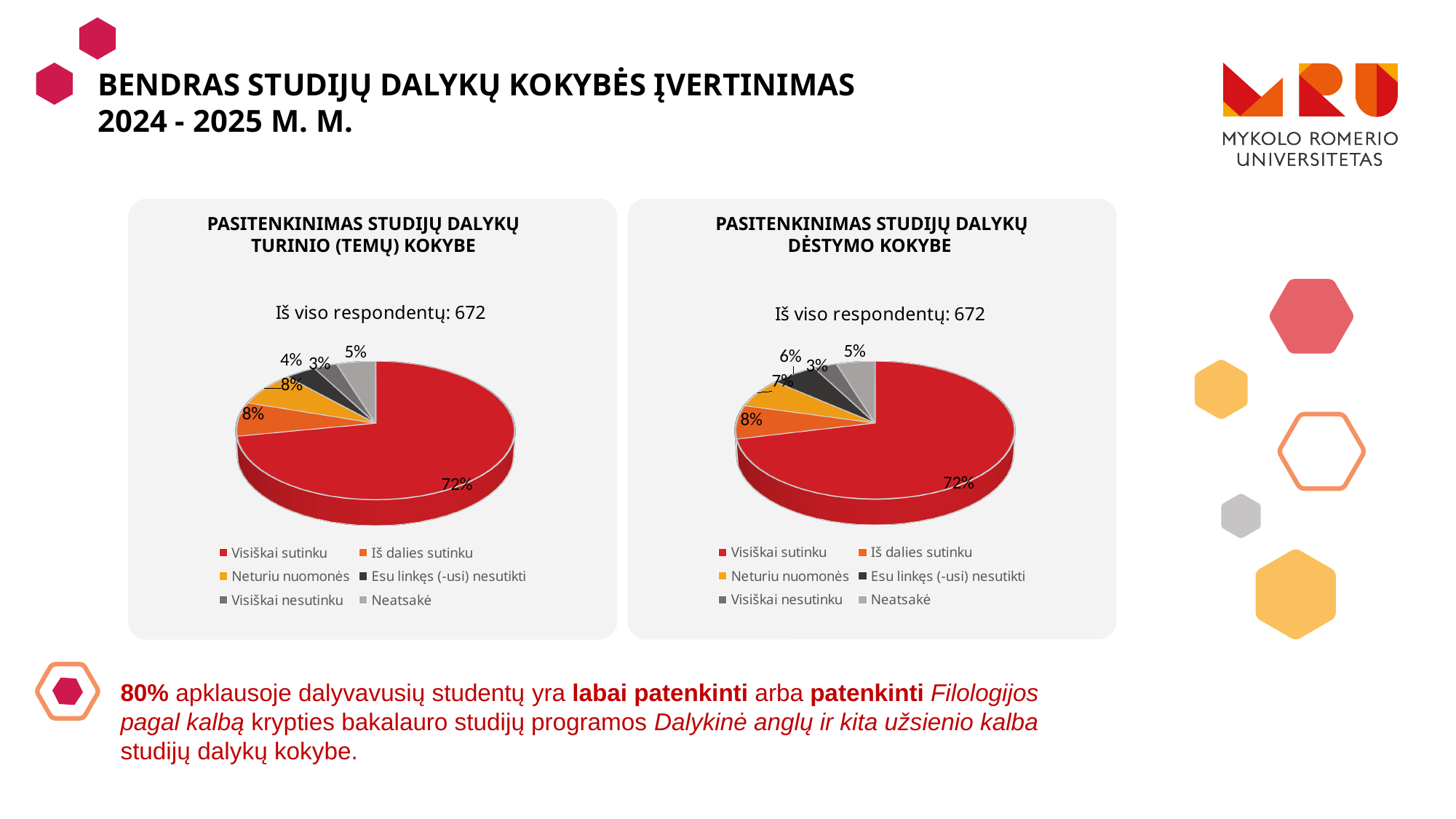
How many respondents in total are reported for the left chart (TURINIO (TEMŲ) KOKYBE)? 672 In the right chart (DĖSTYMO KOKYBE), which category has the smallest slice? Visiškai nesutinku In the right chart (DĖSTYMO KOKYBE), what share of respondents answered 'Esu linkęs (-usi) nesutikti'? 6% In the left chart (TURINIO (TEMŲ) KOKYBE), what share of respondents answered 'Esu linkęs (-usi) nesutikti'? 4% In the left chart (TURINIO (TEMŲ) KOKYBE), what share of respondents answered 'Visiškai sutinku'? 72% In the left chart (TURINIO (TEMŲ) KOKYBE), which is larger: the 'Neatsakė' share or the 'Visiškai nesutinku' share? Neatsakė In the left chart (TURINIO (TEMŲ) KOKYBE), which category has the largest slice? Visiškai sutinku In the right chart (DĖSTYMO KOKYBE), what is the difference between the 'Visiškai sutinku' share and the 'Iš dalies sutinku' share? 64% What type of chart is used on the left, titled 'PASITENKINIMAS STUDIJŲ DALYKŲ TURINIO (TEMŲ) KOKYBE'? Pie chart How many categories does the legend of the right chart (DĖSTYMO KOKYBE) list? 6 In the left chart (TURINIO (TEMŲ) KOKYBE), what colour is the 'Visiškai sutinku' slice? Red